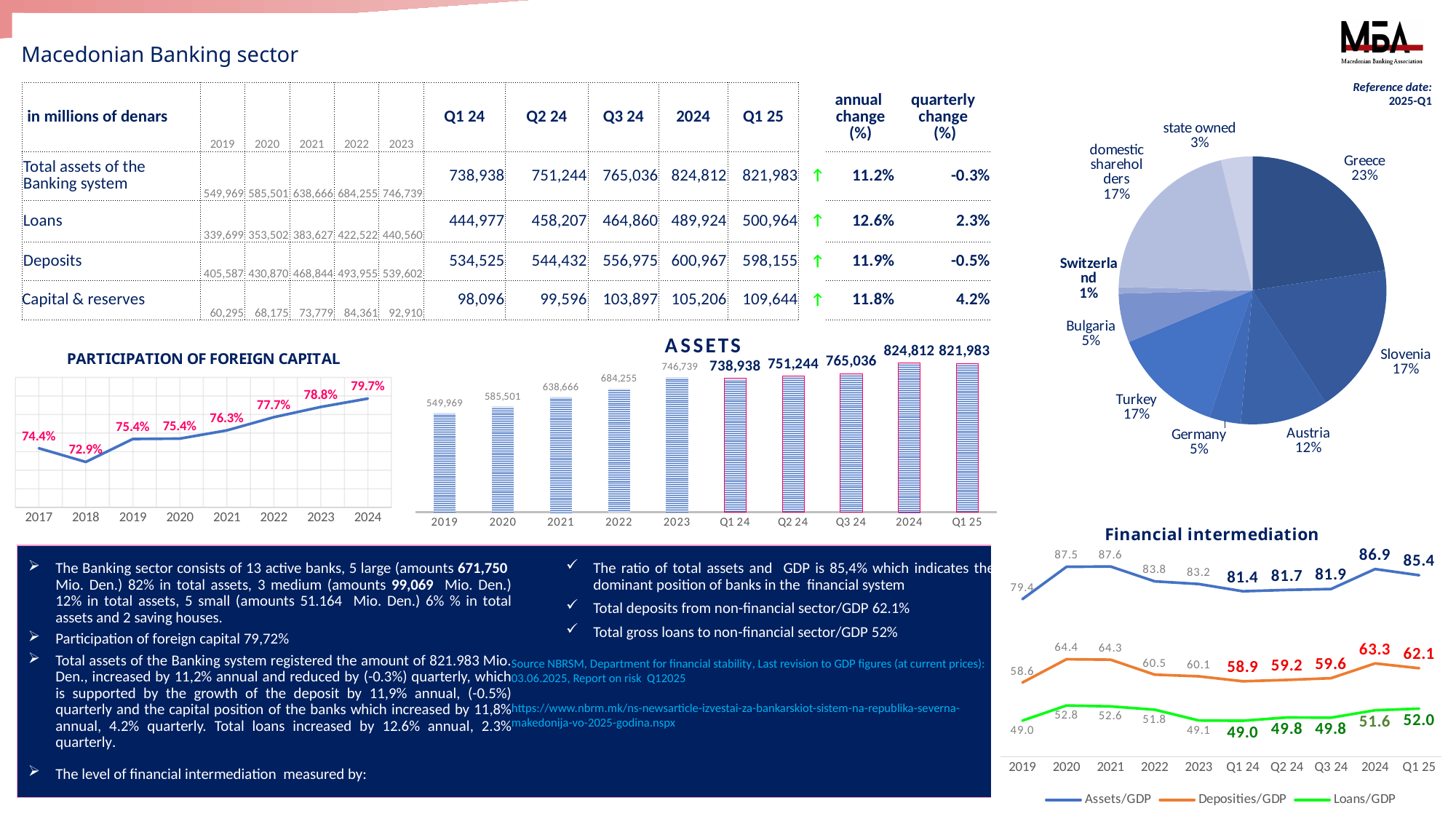
In the ASSETS chart, what is the difference between the 2024 and Q1 25 values? 2,829 What kind of chart is the ASSETS chart? Bar chart In the pie chart, what share does Greece have? 23% In the PARTICIPATION OF FOREIGN CAPITAL chart, what is the value for 2024? 79.7% In the PARTICIPATION OF FOREIGN CAPITAL chart, how many years are plotted? 8 In the Financial intermediation chart, what is the Assets/GDP value for Q1 25? 85.4 In the pie chart, which country has the smallest share? Switzerland In the PARTICIPATION OF FOREIGN CAPITAL chart, which year has the lowest value? 2018 In the Financial intermediation chart, is the Deposities/GDP value for 2024 larger or smaller than the Loans/GDP value for 2024? Larger How many series does the legend of the Financial intermediation chart list? 3 In the ASSETS chart, what is the value for Q3 24? 765,036 In the ASSETS chart, which period has the highest value? 2024